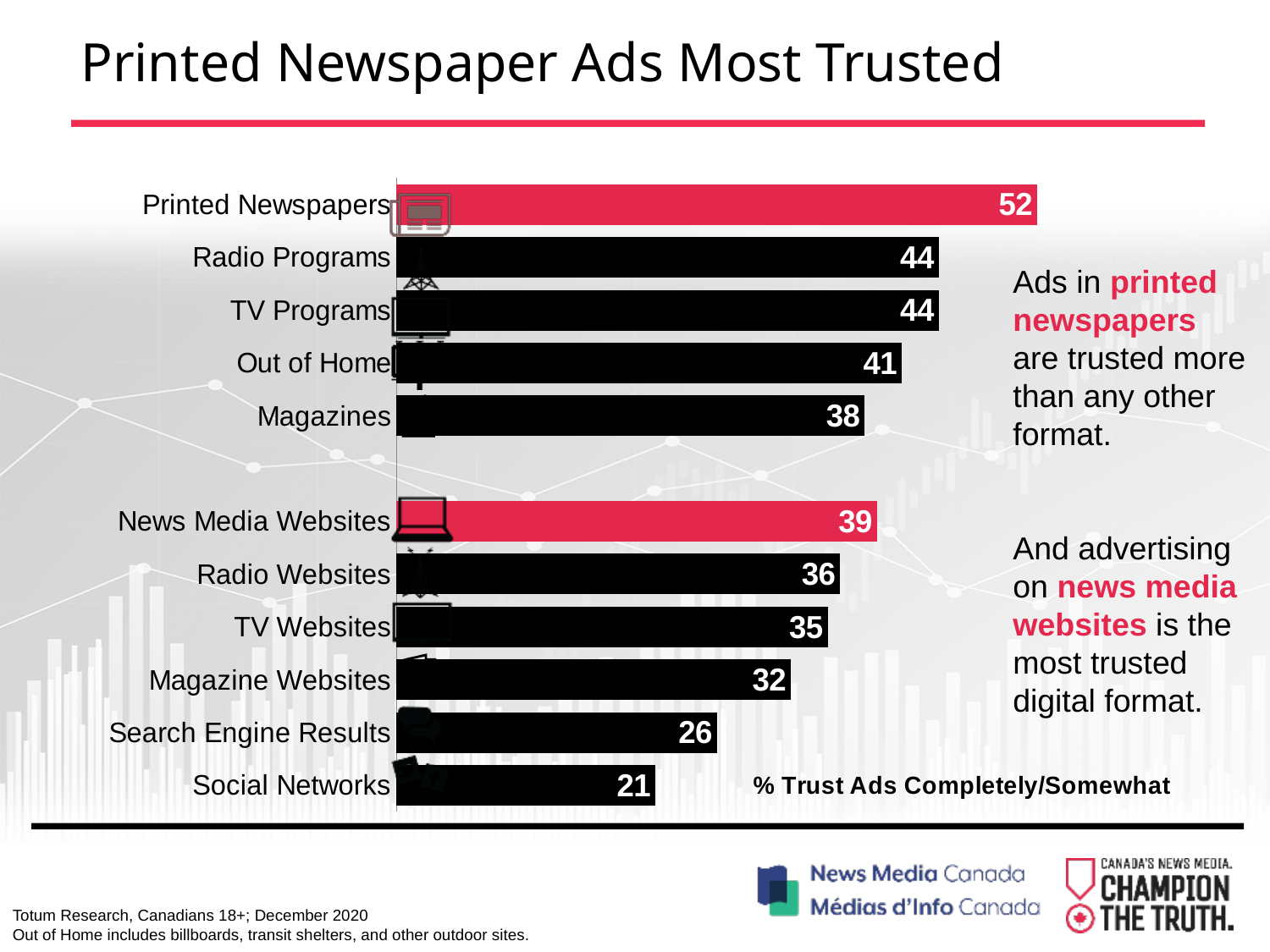
Which category has the highest value? Printed Newspapers Which is larger, the value for Out of Home or the value for Magazines? Out of Home What is the title of the slide? Printed Newspaper Ads Most Trusted Which is larger, the value for Radio Websites or the value for TV Websites? Radio Websites What is the value for Printed Newspapers? 52 Which category has the lowest value? Social Networks How many categories are shown in the chart? 11 What is the value for News Media Websites? 39 What is the value for Search Engine Results? 26 What is the difference between the values for News Media Websites and Magazine Websites? 7 What kind of chart is shown on the slide? Bar chart What is the difference between the values for Printed Newspapers and Social Networks? 31